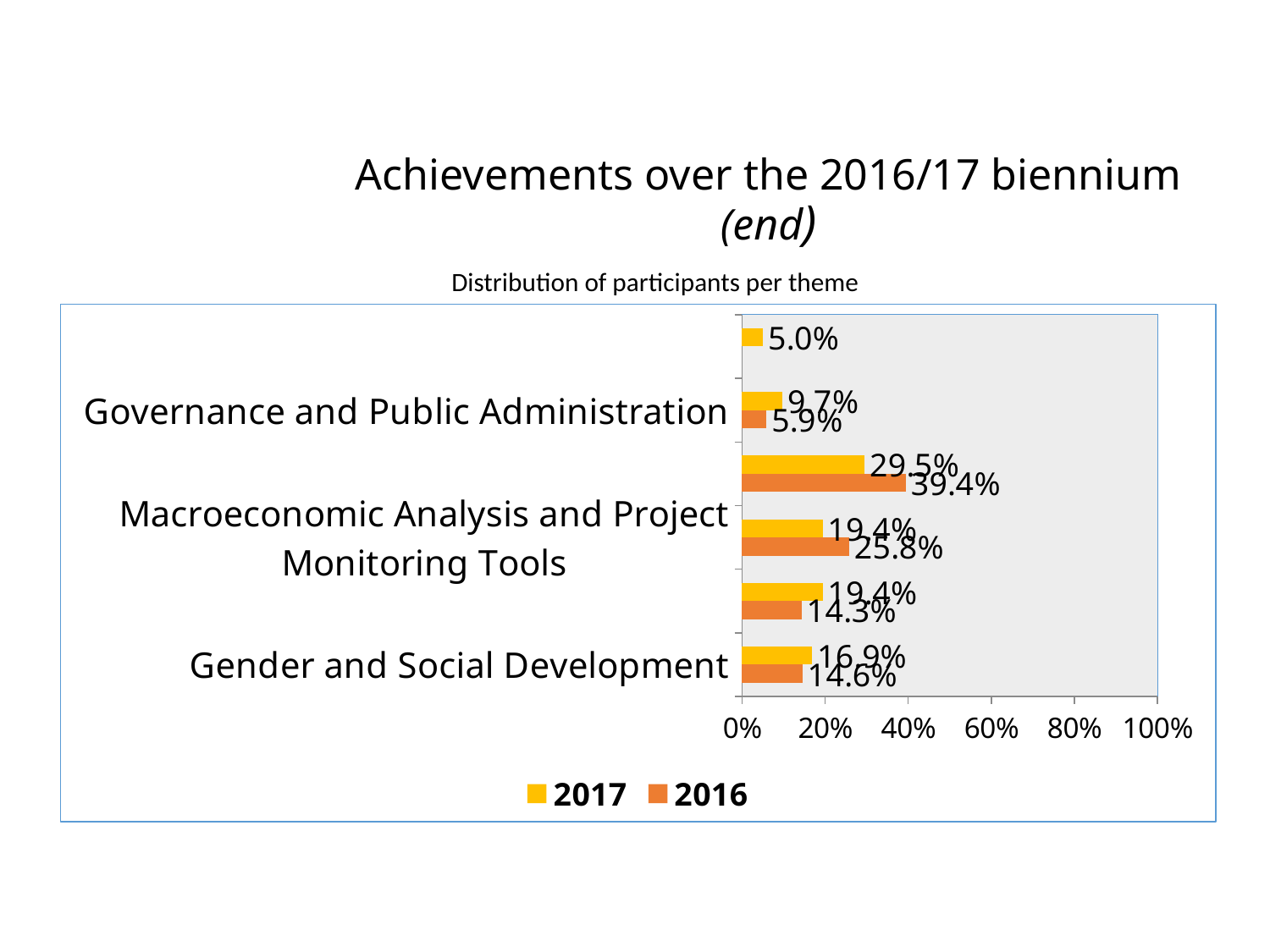
What is the difference between the 2016 and 2017 values for Macroeconomic Analysis and Project Monitoring Tools? 6.4% What is the 2017 value for Gender and Social Development? 16.9% What is the 2017 value for Governance and Public Administration? 9.7% How many series does the legend list? 2 What is the 2017 value for Macroeconomic Analysis and Project Monitoring Tools? 19.4% What is the title of the chart? Distribution of participants per theme For Macroeconomic Analysis and Project Monitoring Tools, which year has the larger share, 2016 or 2017? 2016 What is the 2016 value for Macroeconomic Analysis and Project Monitoring Tools? 25.8% What type of chart is shown on the slide? Bar chart What is the 2016 value for Gender and Social Development? 14.6% What is the difference between the 2017 and 2016 values for Governance and Public Administration? 3.8% What is the 2016 value for Governance and Public Administration? 5.9%